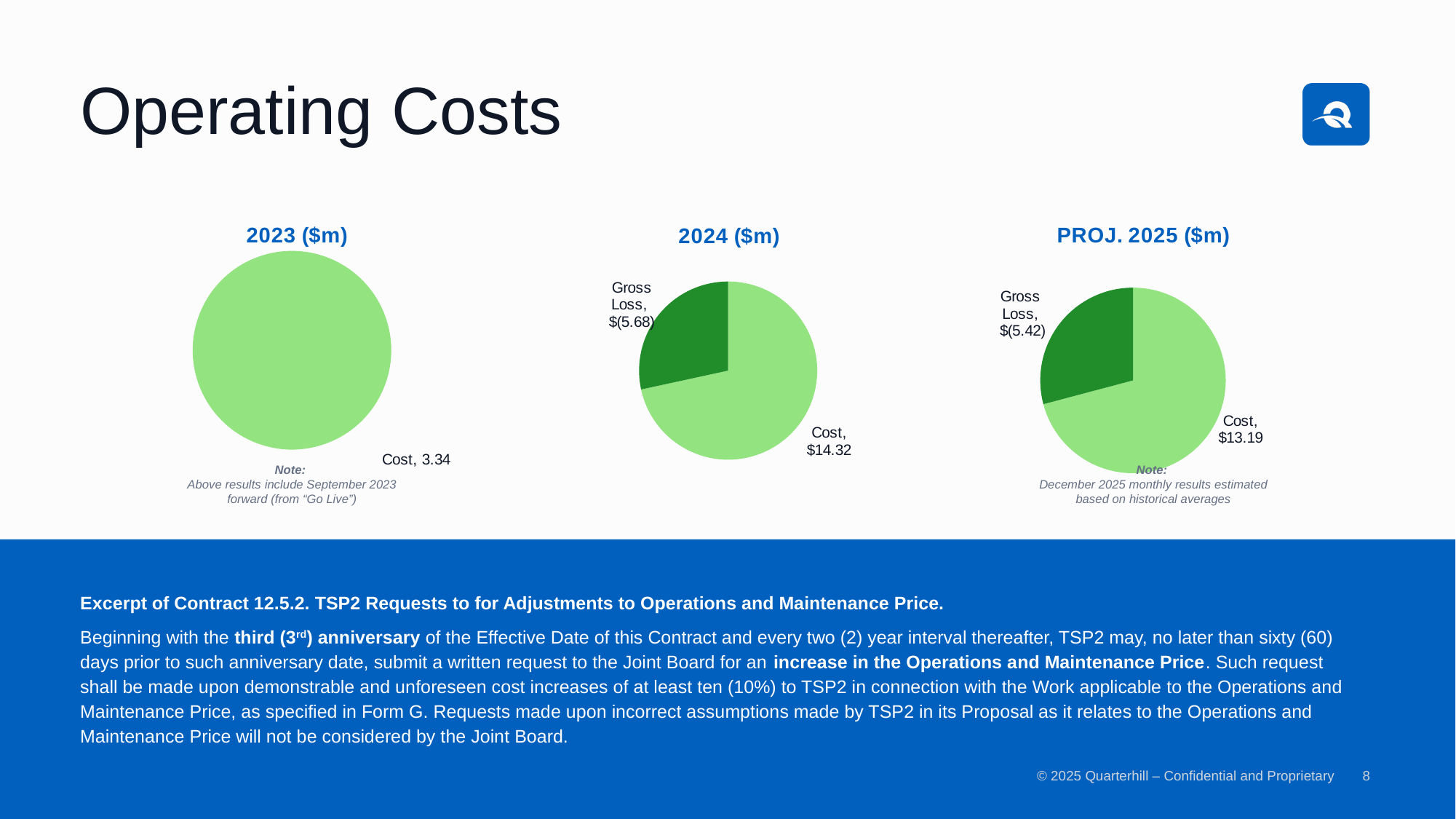
In the 2024 ($m) chart, which slice is larger, Cost or Gross Loss? Cost What kind of chart is the 2024 ($m) chart? Pie chart In the 2024 ($m) chart, what is the value for Cost? $14.32 In the PROJ. 2025 ($m) chart, what is the value for Cost? $13.19 In the 2024 ($m) chart, what is the value for Gross Loss? $(5.68) How many slices does the PROJ. 2025 ($m) pie chart have? 2 How many slices does the 2023 ($m) pie chart have? 1 Is the Cost value in the 2024 ($m) chart larger or smaller than the Cost value in the PROJ. 2025 ($m) chart? Larger In the PROJ. 2025 ($m) chart, which slice is the largest? Cost How many pie charts are shown on the slide? 3 In the 2023 ($m) chart, what is the value for Cost? 3.34 In the PROJ. 2025 ($m) chart, what is the value for Gross Loss? $(5.42)